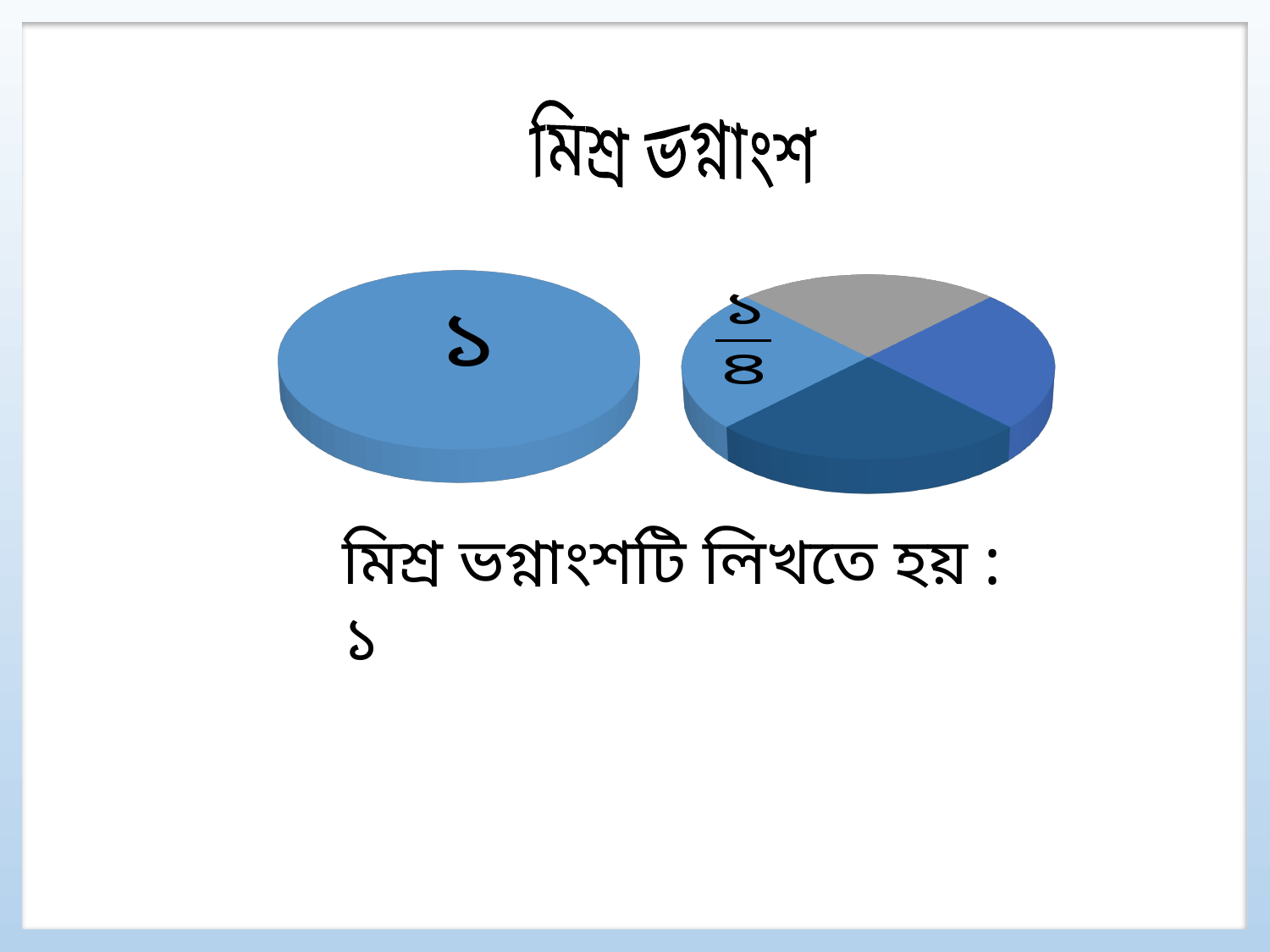
How many slices does the pie chart on the right of the slide have? 4 What label is printed on the labelled slice of the pie chart on the right of the slide? ১/৪ What kind of chart is the chart on the left of the slide? pie chart In the pie chart on the right of the slide, what share of the pie does the labelled slice represent? ১/৪ What is the title shown above the charts on the slide? মিশ্র ভগ্নাংশ What label is printed on the pie chart on the left of the slide? ১ What colour is the pie chart on the left of the slide? blue How many slices does the pie chart on the left of the slide have? 1 How many charts are shown on the slide? 2 What kind of chart is the chart on the right of the slide? pie chart